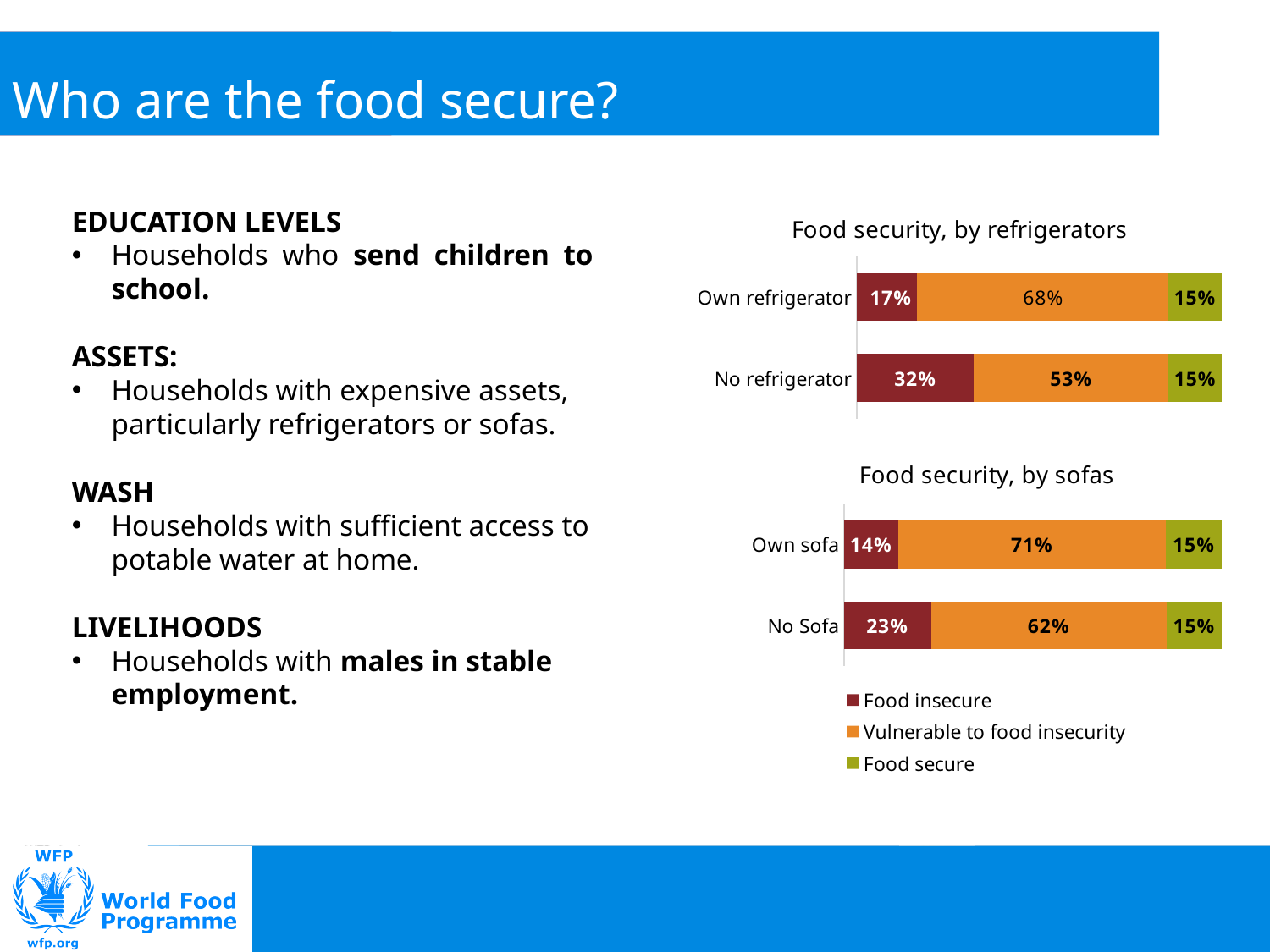
In the 'Food security, by refrigerators' chart, what percentage of households that own a refrigerator are food insecure? 17% How many series does the legend list? 3 In the 'Food security, by sofas' chart, which category has the larger vulnerable to food insecurity share: Own sofa or No Sofa? Own sofa Which legend entry is shown in green? Food secure In the 'Food security, by refrigerators' chart, what percentage of households with no refrigerator are vulnerable to food insecurity? 53% In the 'Food security, by sofas' chart, what is the total of the No Sofa bar? 100% What kind of chart is 'Food security, by sofas'? Stacked bar chart How many categories are shown in the 'Food security, by refrigerators' chart? 2 In the 'Food security, by refrigerators' chart, what is the difference in the food insecure share between households with no refrigerator and those that own one? 15% In the 'Food security, by sofas' chart, what percentage of households with no sofa are food insecure? 23% In the 'Food security, by sofas' chart, what percentage of households that own a sofa are vulnerable to food insecurity? 71% In the 'Food security, by refrigerators' chart, which category has the higher food insecure share? No refrigerator